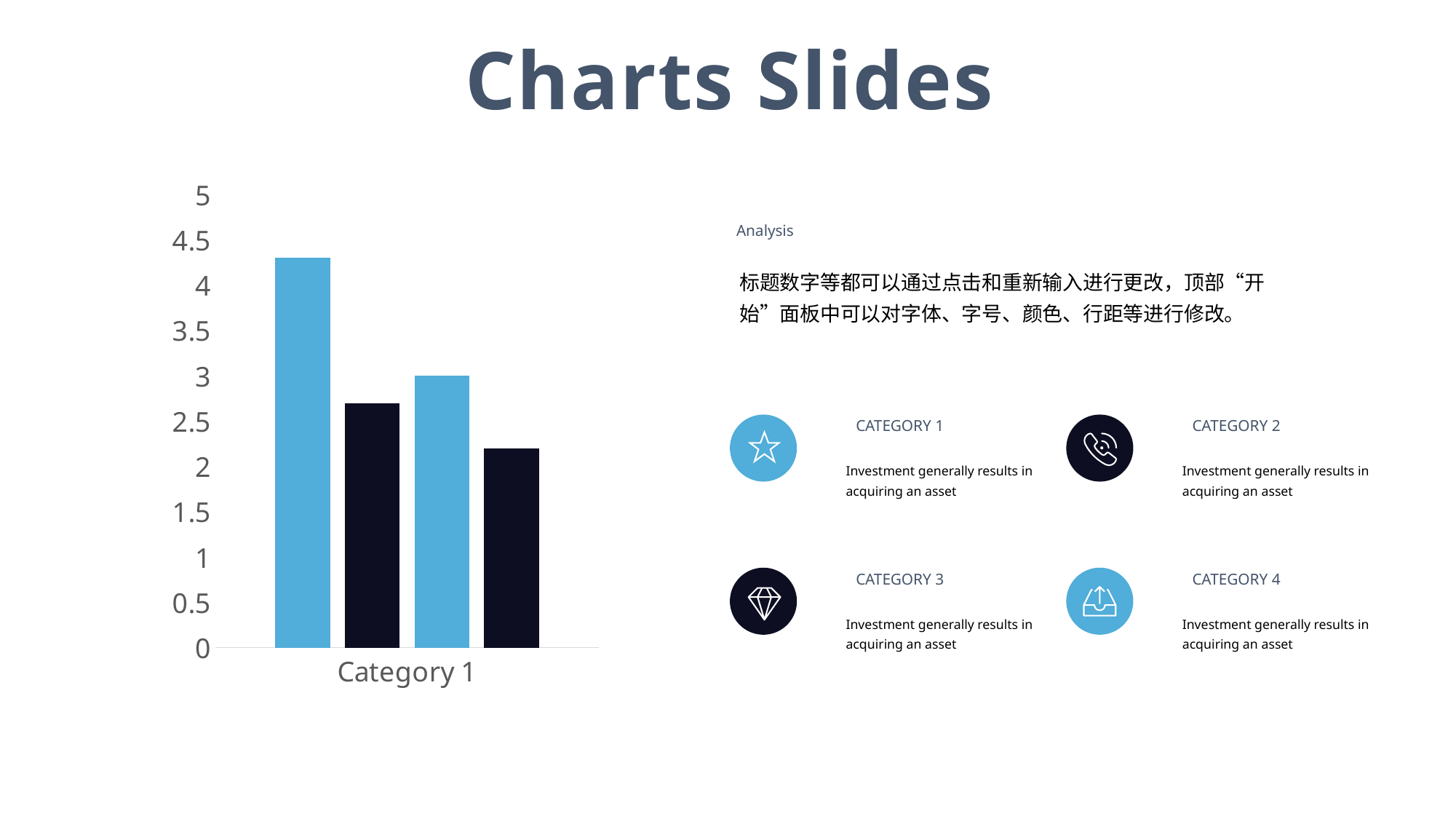
What is the highest value shown on the chart's y axis? 5 How many bars are plotted in the chart? 4 Is the value of the rightmost bar greater or less than 2.5? less What kind of chart is shown on the slide? bar chart Is the value of the rightmost bar greater or less than 2? greater Which is larger, the second bar from the left or the third bar from the left? the third bar from the left Which bar in the chart is the shortest? the rightmost (fourth) bar Is the value of the leftmost bar greater or less than 4? greater Which bar in the chart is the tallest? the leftmost (first) bar How many categories are shown on the x axis of the chart? 1 What is the category label shown on the x axis of the chart? Category 1